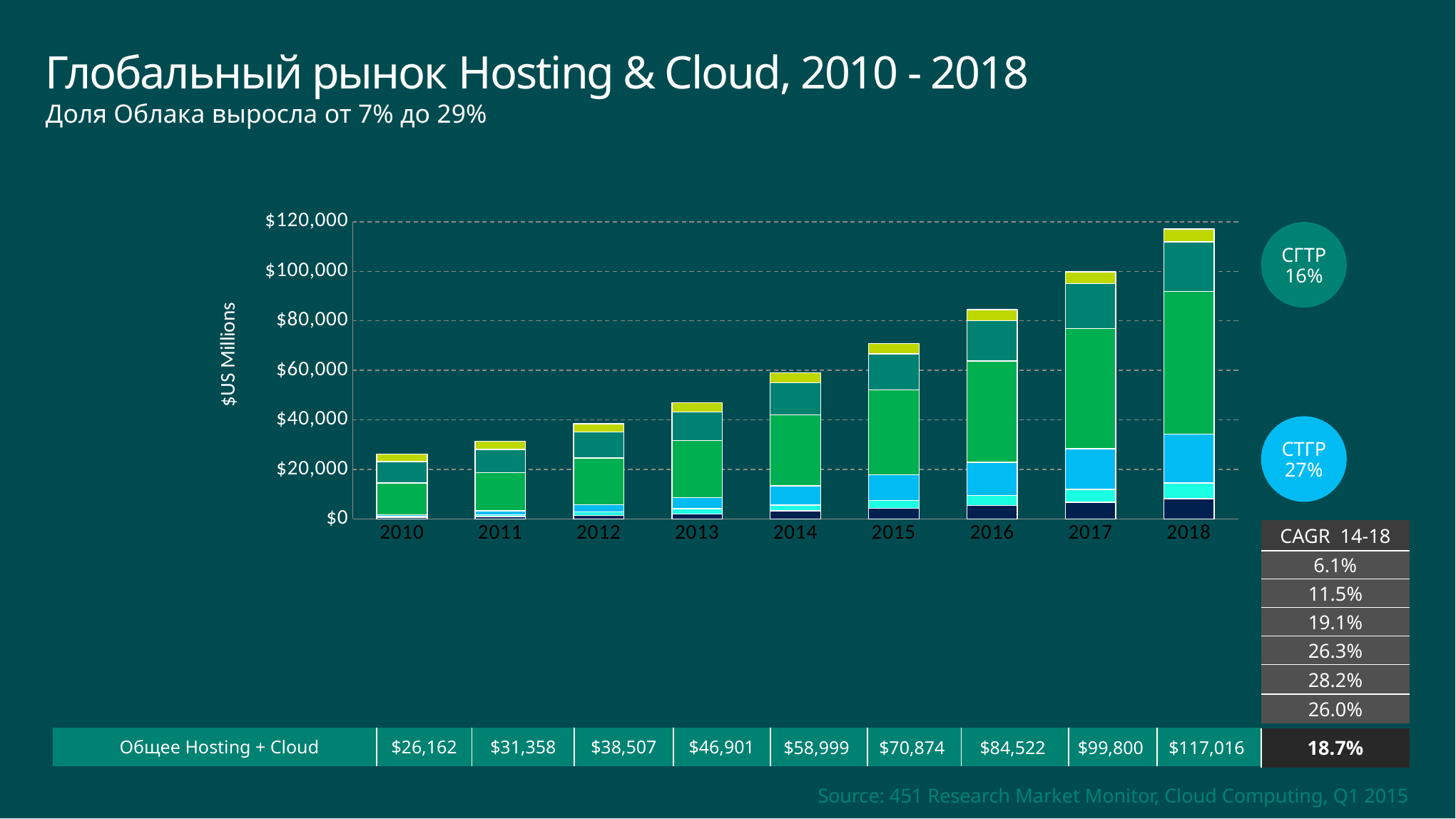
What is the total Hosting + Cloud value for 2010? $26,162 What is the difference between the total Hosting + Cloud values for 2018 and 2017? $17,216 What is the total Hosting + Cloud value for 2018? $117,016 Do the total bar heights rise or fall from 2010 to 2018? rise What unit is shown on the y axis label of the chart? $US Millions How many years are plotted along the x axis of the chart? 9 Is the total bar for 2013 greater or less than $40,000? greater What is the total Hosting + Cloud value for 2014? $58,999 Which year has the lowest total Hosting + Cloud value? 2010 What kind of chart is shown on the slide? stacked bar chart Which year has a larger total Hosting + Cloud value, 2015 or 2016? 2016 Which year has the highest total Hosting + Cloud value? 2018